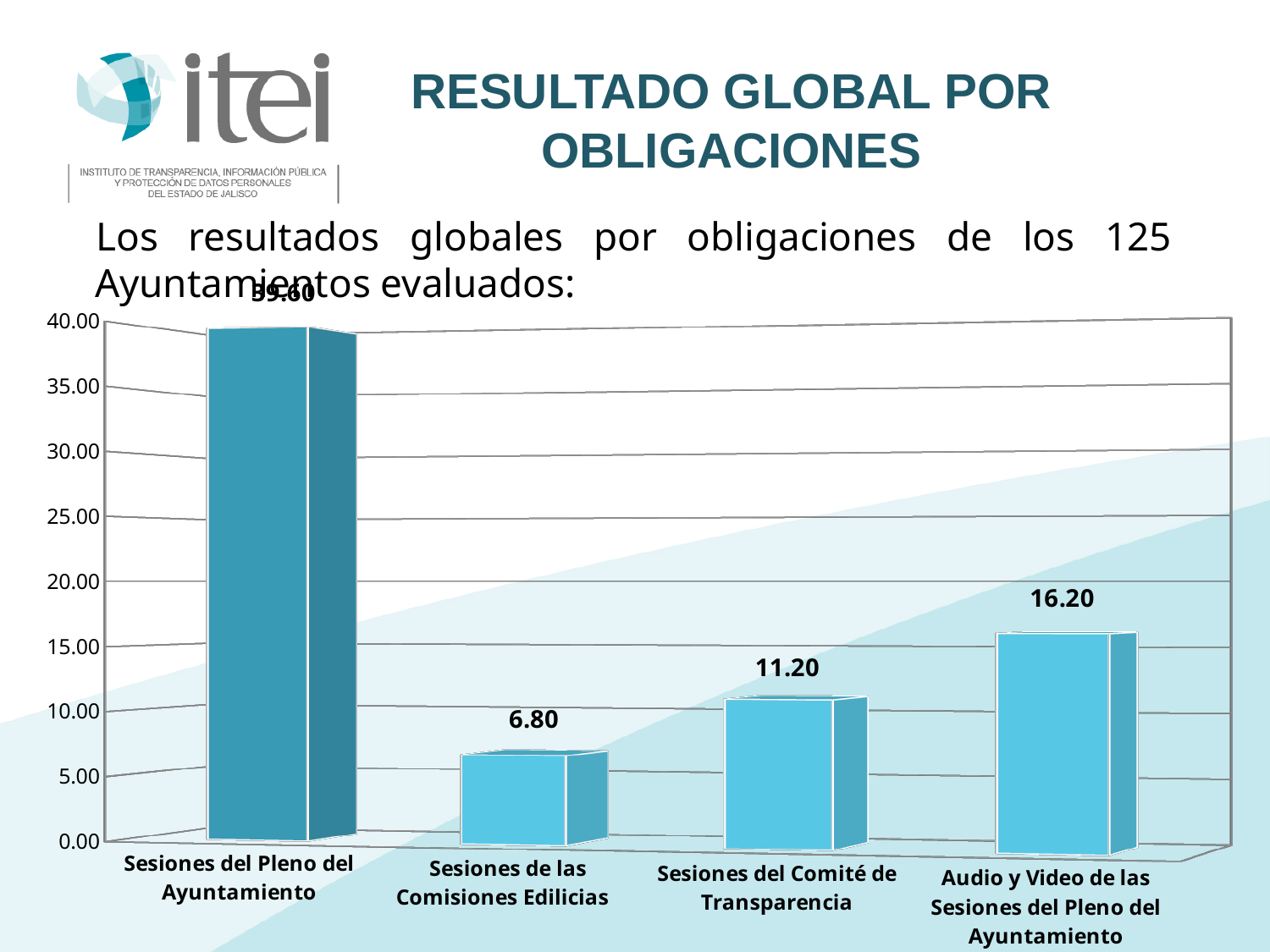
What is the value for Audio y Video de las Sesiones del Pleno del Ayuntamiento? 16.20 What is the value for Sesiones de las Comisiones Edilicias? 6.80 What is the value for Sesiones del Comité de Transparencia? 11.20 Is the value for Sesiones de las Comisiones Edilicias greater or less than 10.00? less How many categories are shown in the chart? 4 Is the value for Sesiones del Pleno del Ayuntamiento greater or less than 35.00? greater Which is larger, the value for Sesiones del Comité de Transparencia or the value for Audio y Video de las Sesiones del Pleno del Ayuntamiento? Audio y Video de las Sesiones del Pleno del Ayuntamiento Which category has the highest value? Sesiones del Pleno del Ayuntamiento Which category has the lowest value? Sesiones de las Comisiones Edilicias What is the difference between the values for Audio y Video de las Sesiones del Pleno del Ayuntamiento and Sesiones de las Comisiones Edilicias? 9.40 What is the difference between the values for Sesiones del Comité de Transparencia and Sesiones de las Comisiones Edilicias? 4.40 What kind of chart is shown on the slide? bar chart